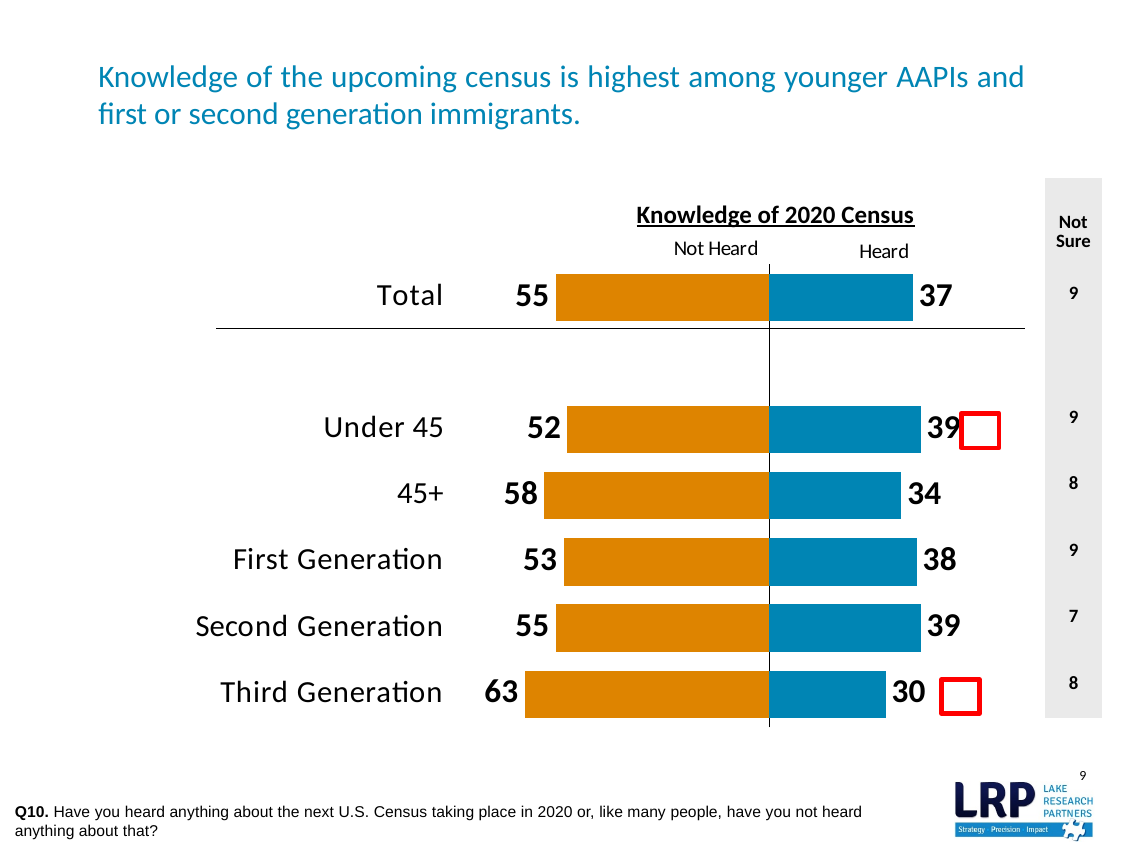
How many series does the chart show (excluding the Not Sure column)? 2 What kind of chart is shown on the slide? Bar chart Which category has the lowest "Heard" value? Third Generation What is the difference between the "Not Heard" values for 45+ and Under 45? 6 How many categories are shown in the chart? 6 What is the "Not Sure" value for Second Generation? 7 Which category has the highest "Not Heard" value? Third Generation What is the title of the chart? Knowledge of 2020 Census Which has a larger "Heard" value, First Generation or Second Generation? Second Generation What is the "Heard" value for 45+? 34 What is the "Not Heard" value for Third Generation? 63 What is the "Heard" value for Total? 37